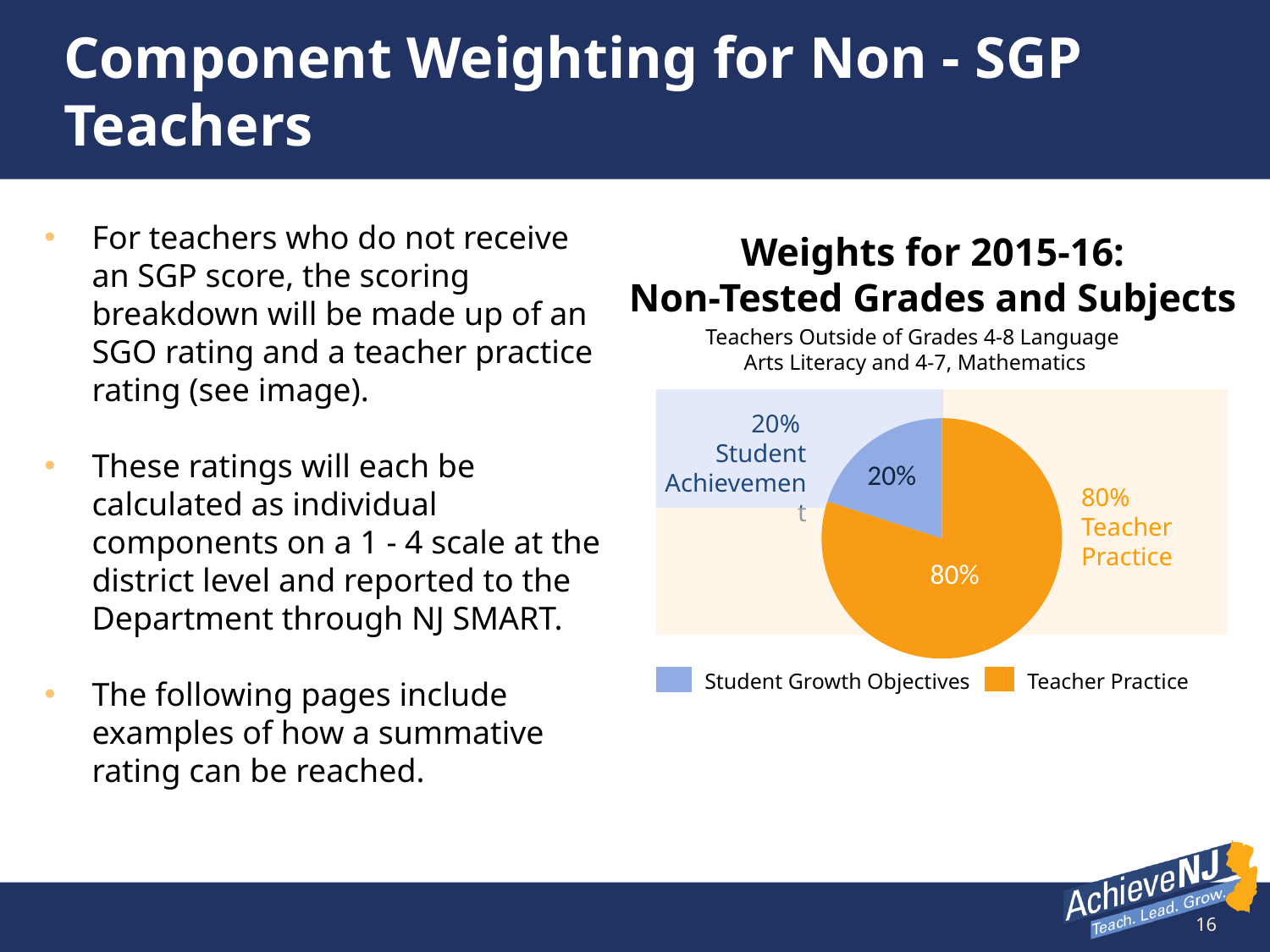
How many entries does the legend list? 2 Which slice of the pie is the smallest? Student Growth Objectives What is the difference in percentage points between the Teacher Practice slice and the Student Growth Objectives slice? 60 What share of the pie does Teacher Practice represent? 80% Which is larger, the Teacher Practice slice or the Student Growth Objectives slice? Teacher Practice What is the title of the chart? Weights for 2015-16: Non-Tested Grades and Subjects What share of the pie does Student Growth Objectives represent? 20% What kind of chart is shown on the slide? pie chart Which slice of the pie is the largest? Teacher Practice What colour is the Teacher Practice slice? orange How many slices does the pie chart have? 2